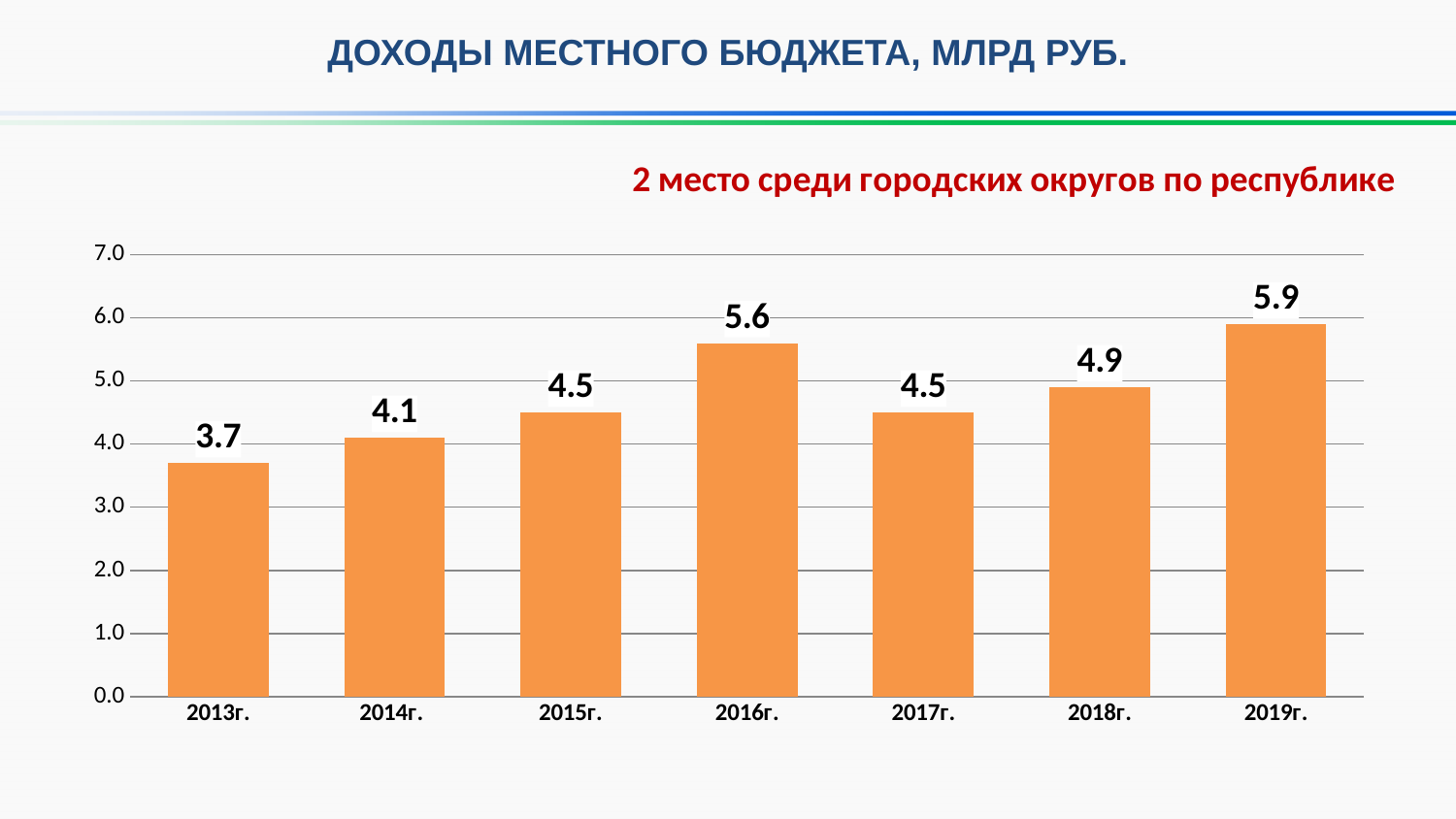
What is the difference between the values for 2019г. and 2013г.? 2.2 Which is larger, the value for 2016г. or the value for 2018г.? 2016г. What is the value for 2018г.? 4.9 What is the value for 2013г.? 3.7 Which year has the lowest value? 2013г. What is the difference between the values for 2016г. and 2017г.? 1.1 What is the title of the chart? ДОХОДЫ МЕСТНОГО БЮДЖЕТА, МЛРД РУБ. How many years are shown on the chart? 7 What kind of chart is shown on the slide? bar chart Which year has the highest value? 2019г. Is the value for 2019г. greater or less than 5.0? greater What is the value for 2016г.? 5.6